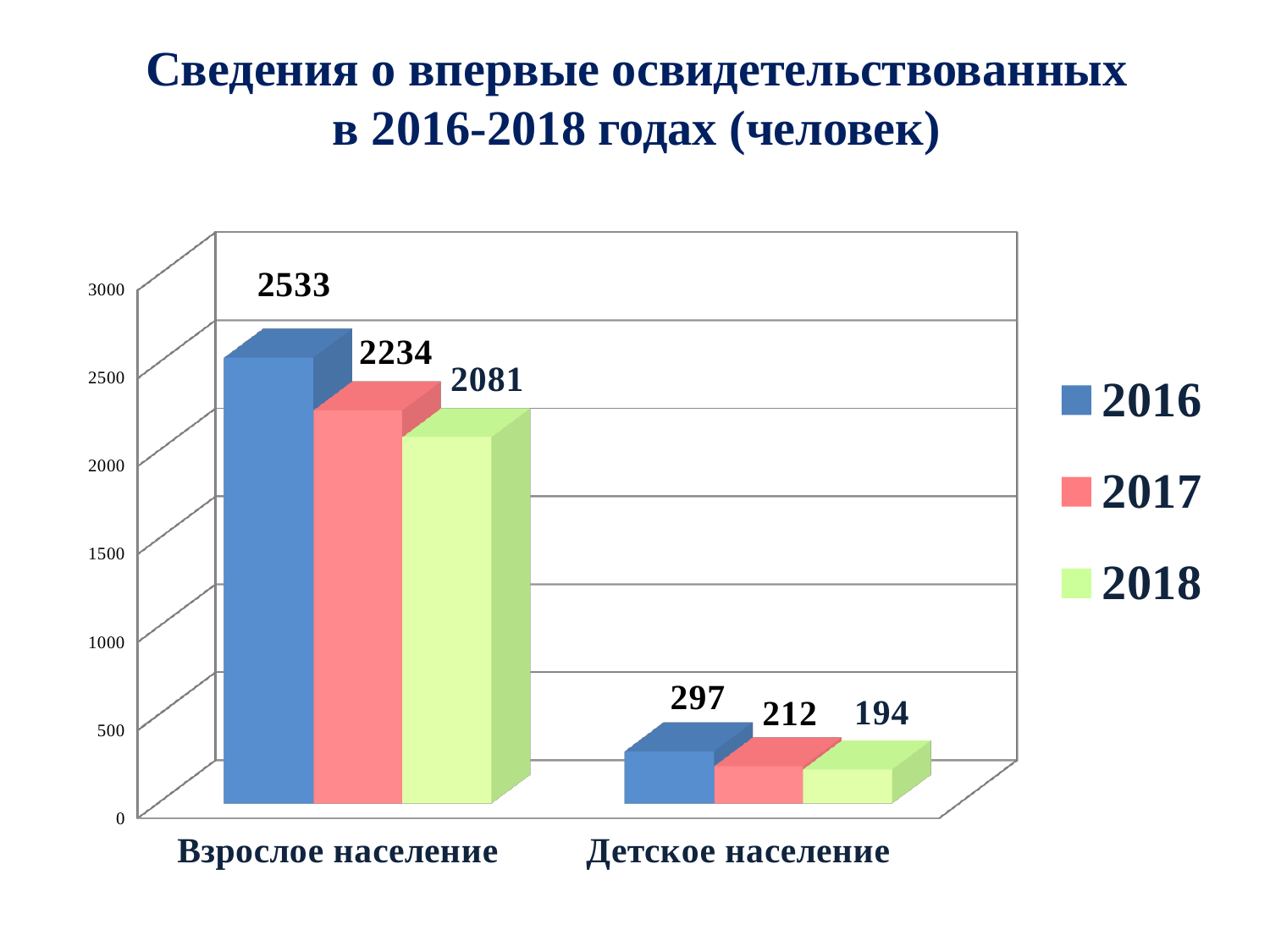
Which is larger: the 2017 value for Взрослое население or the 2017 value for Детское население? Взрослое население What is the value for Взрослое население in 2017? 2234 Which year has the lowest value for Взрослое население? 2018 What is the value for Детское население in 2018? 194 Do the values for Взрослое население rise or fall from 2016 to 2018? Fall How many series does the legend list? 3 How many categories are shown on the x axis? 2 Which year has the highest value for Детское население? 2016 What is the difference between the 2016 and 2017 values for Детское население? 85 What is the value for Взрослое население in 2016? 2533 What is the difference between the 2016 and 2018 values for Взрослое население? 452 What kind of chart is shown on the slide? Bar chart